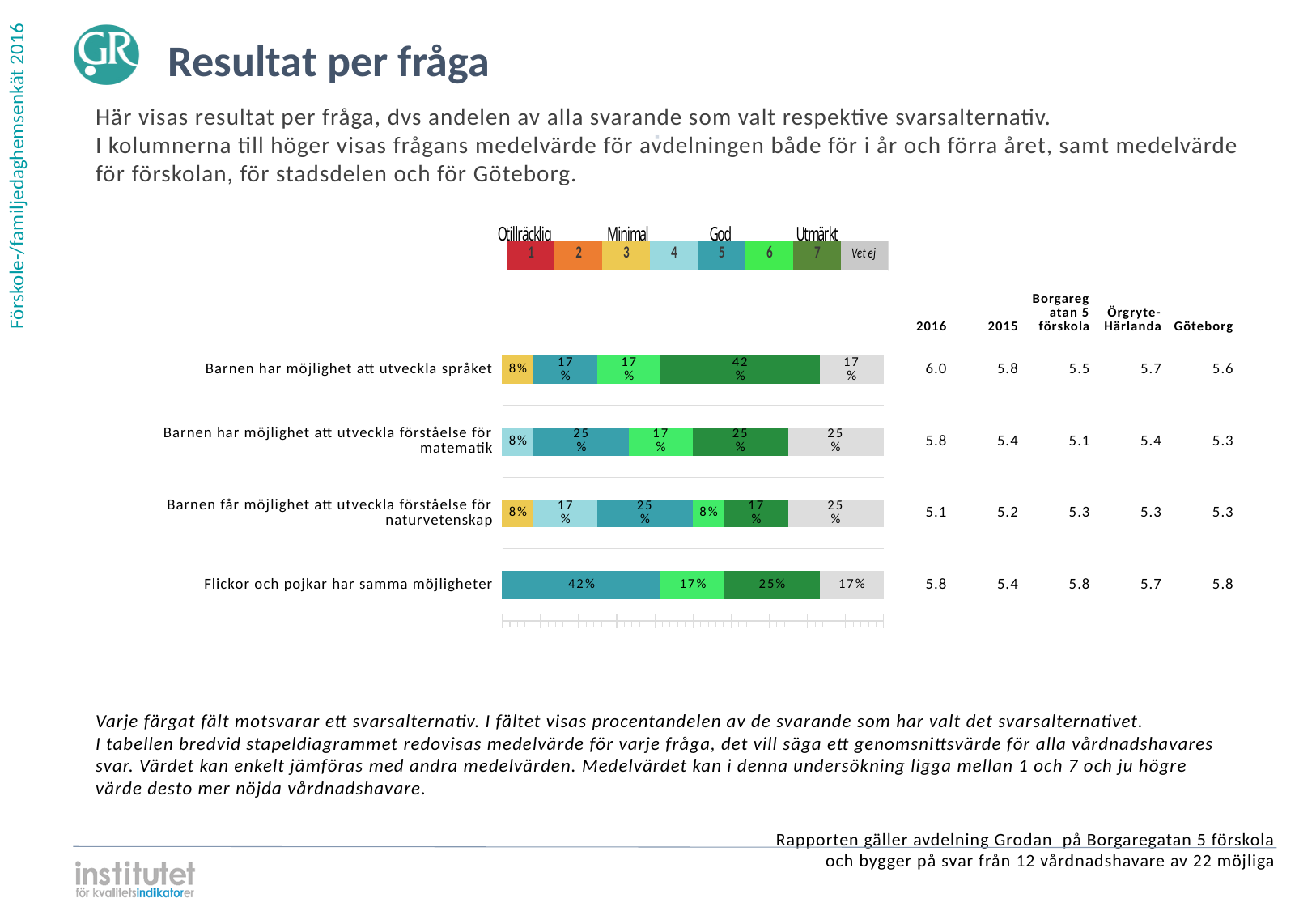
How many response options does the legend above the chart list? 8 What percentage chose option 5 (teal) for 'Flickor och pojkar har samma möjligheter'? 42% What is the total of the printed segment values for 'Barnen har möjlighet att utveckla förståelse för matematik'? 100% What percentage chose 'Vet ej' for 'Barnen har möjlighet att utveckla förståelse för matematik'? 25% What kind of chart is shown on the slide? Stacked bar chart Which response option has the largest share for 'Barnen har möjlighet att utveckla språket'? 7 (Utmärkt) What percentage of respondents chose option 7 (Utmärkt, dark green) for 'Barnen har möjlighet att utveckla språket'? 42% How many questions (categories) are plotted in the bar chart? 4 What percentage chose option 6 (light green) for 'Barnen får möjlighet att utveckla förståelse för naturvetenskap'? 8% Which is larger for 'Barnen får möjlighet att utveckla förståelse för naturvetenskap': the share for option 5 or the share for option 7? Option 5 What is the difference between the option 7 share for 'Barnen har möjlighet att utveckla språket' (42%) and for 'Flickor och pojkar har samma möjligheter' (25%)? 17% Which response option is shown in red in the legend? 1